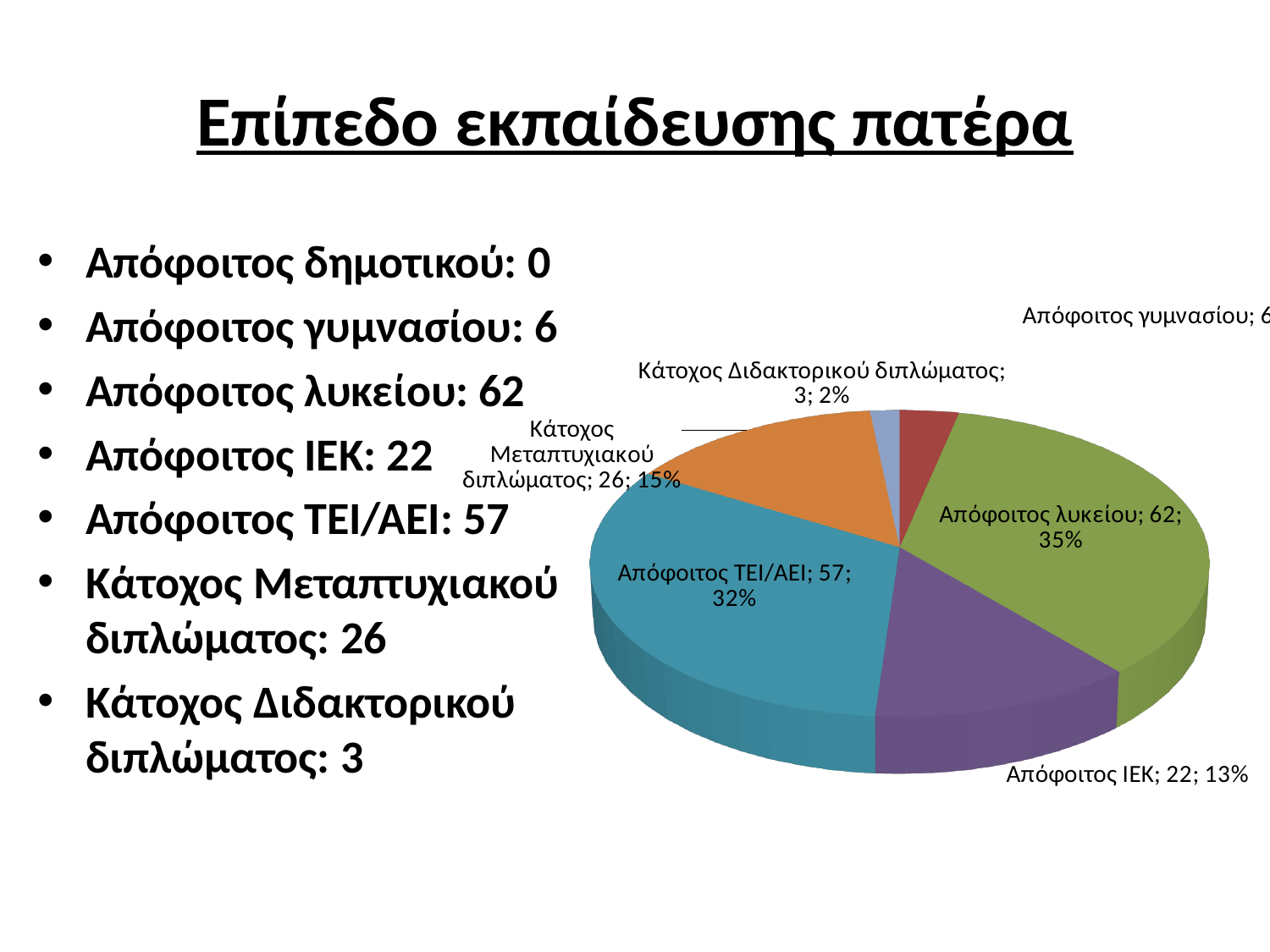
What is the value for Απόφοιτος λυκείου in the pie chart? 62 Which category has the smallest slice in the pie chart? Κάτοχος Διδακτορικού διπλώματος What percentage share does Απόφοιτος ΙΕΚ have in the pie chart? 13% What percentage share does Κάτοχος Διδακτορικού διπλώματος have in the pie chart? 2% Which is larger, the value for Απόφοιτος ΙΕΚ or the value for Κάτοχος Μεταπτυχιακού διπλώματος? Κάτοχος Μεταπτυχιακού διπλώματος What type of chart is shown on the slide? pie chart What is the difference between the values for Απόφοιτος λυκείου and Απόφοιτος ΤΕΙ/ΑΕΙ? 5 What percentage share does Απόφοιτος ΤΕΙ/ΑΕΙ have in the pie chart? 32% Which category has the largest slice in the pie chart? Απόφοιτος λυκείου What is the title of the slide containing the pie chart? Επίπεδο εκπαίδευσης πατέρα How many slices are shown in the pie chart? 6 What is the value for Κάτοχος Μεταπτυχιακού διπλώματος in the pie chart? 26